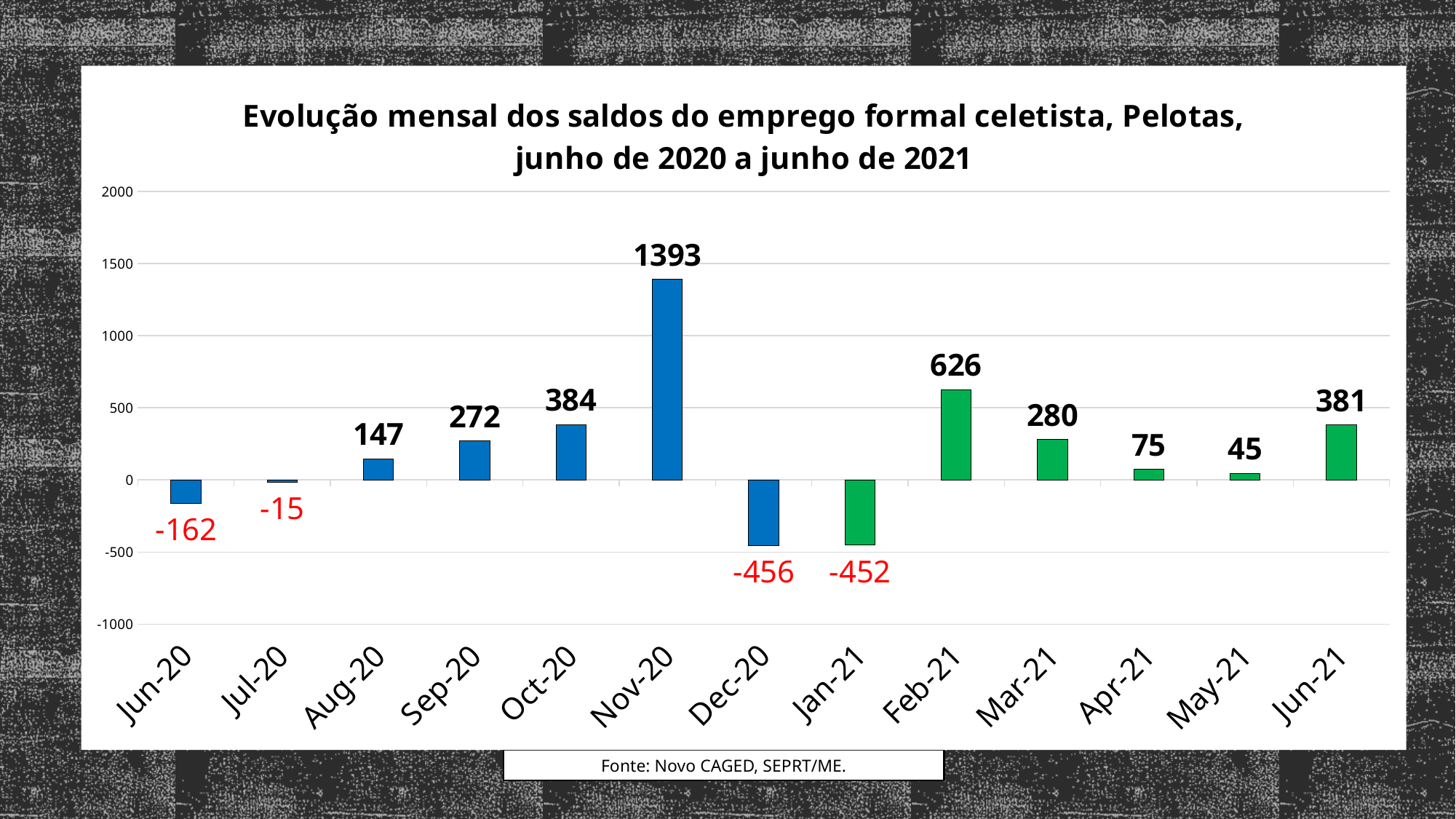
What is the value for Nov-20? 1393 Which month has the lowest value? Dec-20 What is the value for Dec-20? -456 How many months have a negative value? 4 What is the source cited below the chart? Novo CAGED, SEPRT/ME. What is the value for Feb-21? 626 Which is larger, the value for Oct-20 or the value for Mar-21? Oct-20 Which month has the highest value? Nov-20 What kind of chart is this? Bar chart How many months are shown on the x axis? 13 What is the value for Jun-21? 381 What is the difference between the values for Nov-20 and Feb-21? 767